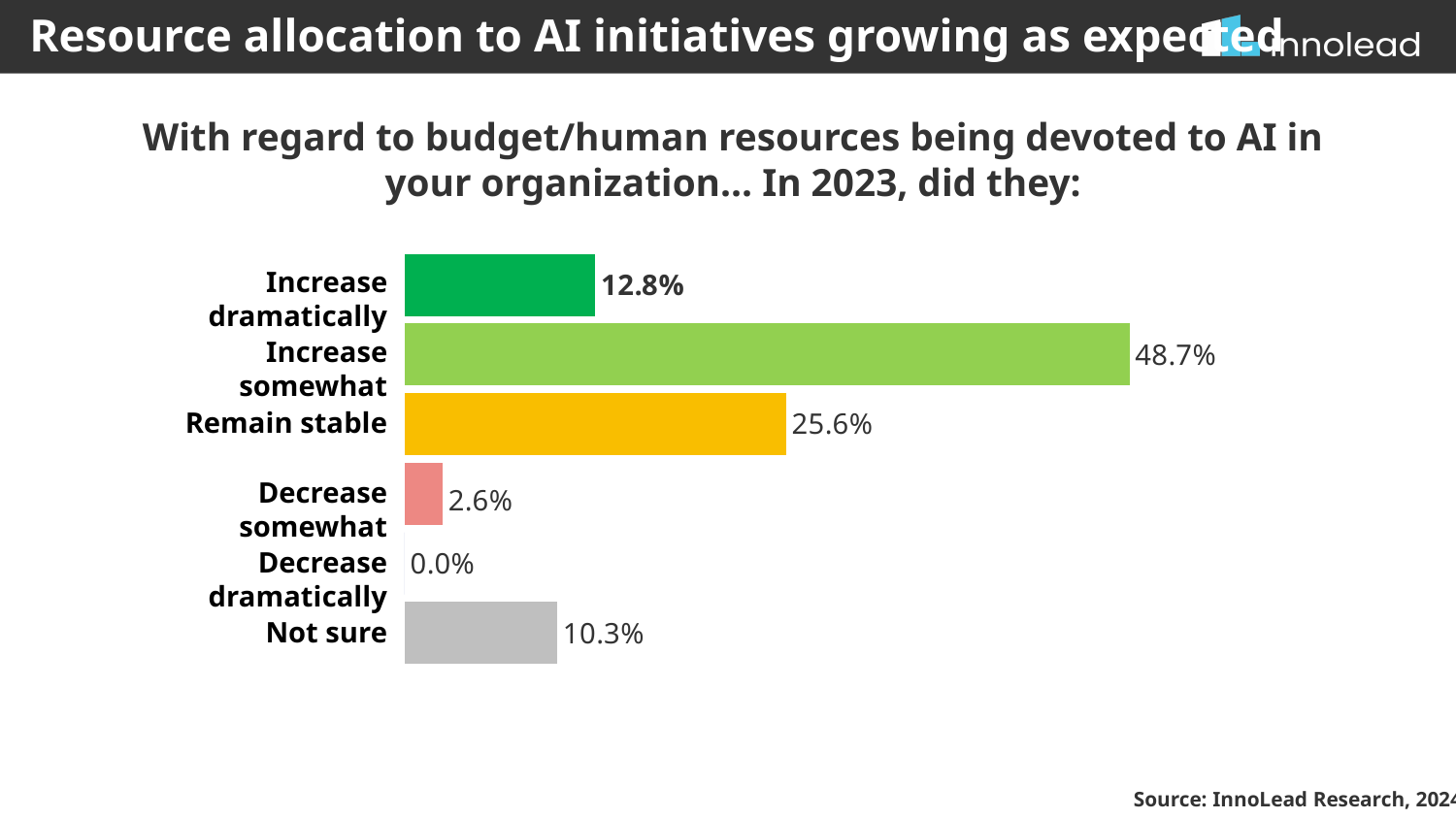
What is the value shown for 'Increase dramatically'? 12.8% What kind of chart is shown on the slide? Bar chart Which is larger, 'Increase dramatically' or 'Not sure'? Increase dramatically What is the value shown for 'Decrease dramatically'? 0.0% What is the value shown for 'Not sure'? 10.3% How many response categories are shown in the chart? 6 Which response category has the lowest value? Decrease dramatically What is the value shown for 'Remain stable'? 25.6% What colour is the bar for 'Remain stable'? Yellow What percentage of respondents said resources devoted to AI would increase somewhat in 2023? 48.7% Which response category has the highest value? Increase somewhat What is the difference between 'Increase somewhat' and 'Remain stable'? 23.1%